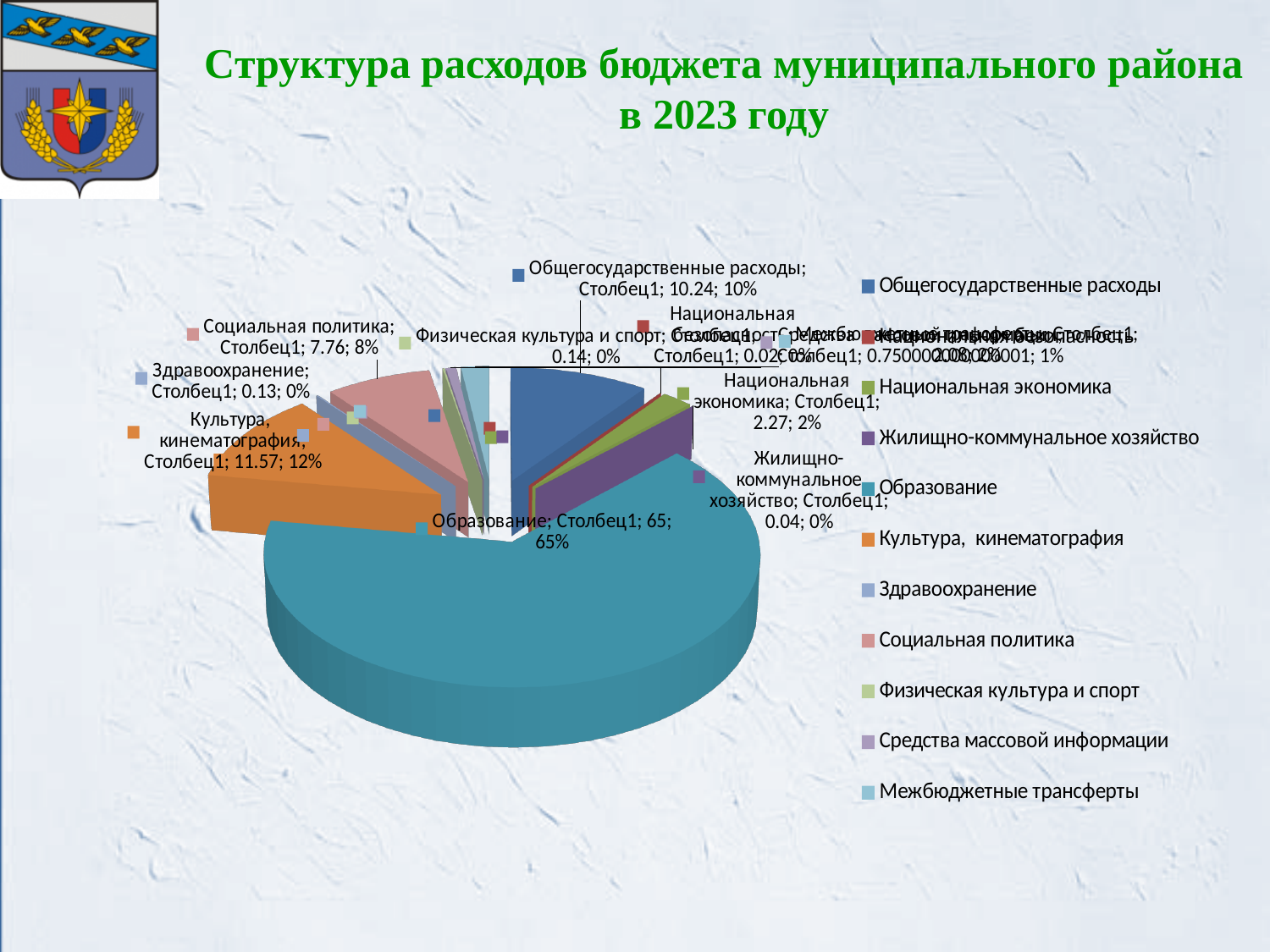
Which category has the largest slice of the pie? Образование What is the title of the chart on the slide? Структура расходов бюджета муниципального района в 2023 году How many categories does the legend of the pie chart list? 11 Which is larger, the value for Общегосударственные расходы or the value for Социальная политика? Общегосударственные расходы What kind of chart is shown on the slide? pie chart What is the value shown for Культура, кинематография? 11.57 What share of the pie does Образование take? 65% What is the value shown for Национальная экономика? 2.27 What is the value shown for Социальная политика? 7.76 What percentage share is shown for Культура, кинематография? 12% What is the value shown for Общегосударственные расходы? 10.24 What is the difference between the values for Культура, кинематография and Социальная политика? 3.81